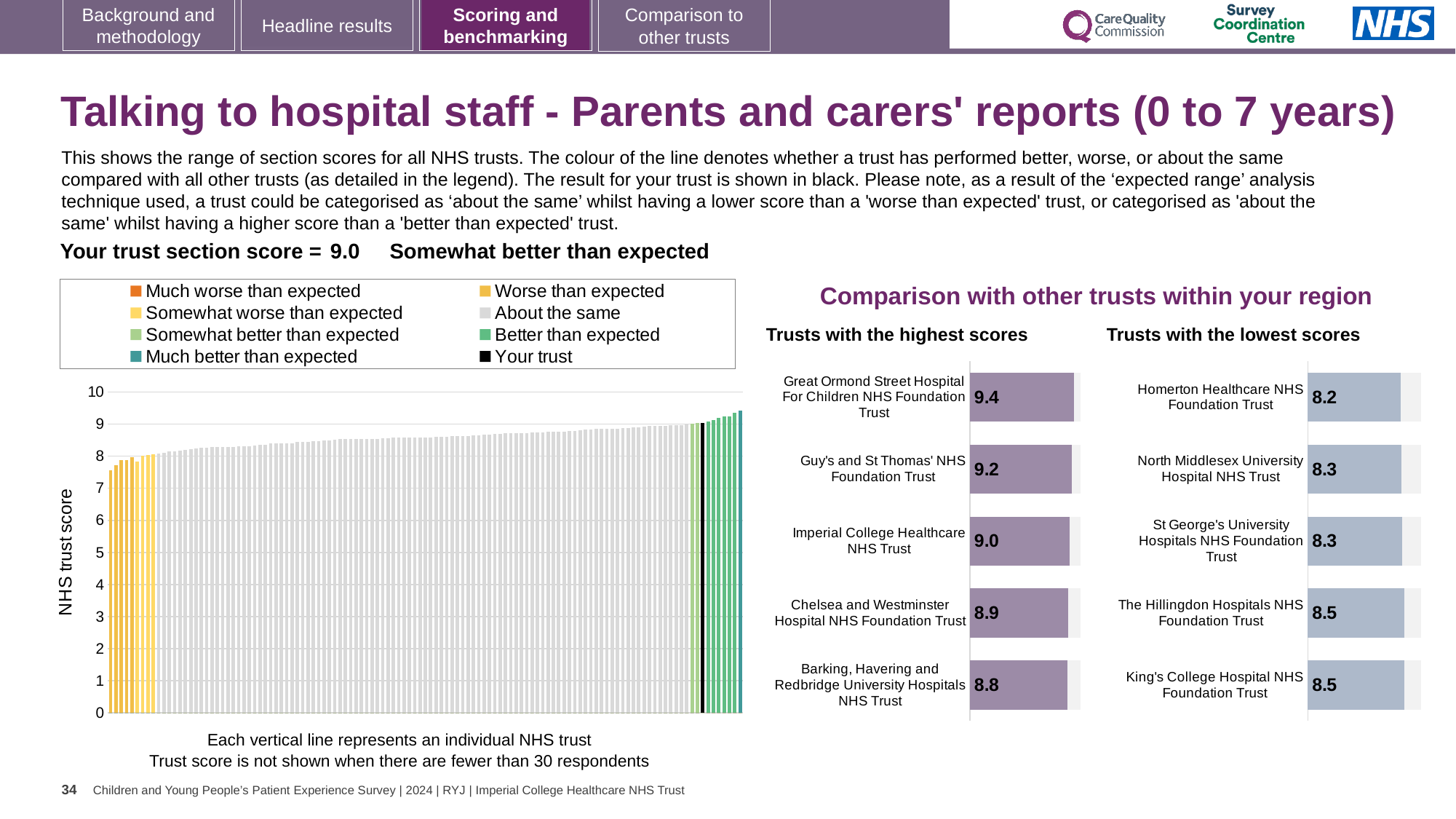
In the 'Trusts with the highest scores' chart, which trust has the lowest score? Barking, Havering and Redbridge University Hospitals NHS Trust What kind of chart is the main chart on the left showing all NHS trusts? Bar chart In the 'Trusts with the highest scores' chart, what is the score for Great Ormond Street Hospital For Children NHS Foundation Trust? 9.4 How many entries does the legend of the main chart on the left list? 8 In the 'Trusts with the highest scores' chart, what is the difference between the scores of Great Ormond Street Hospital For Children NHS Foundation Trust and Barking, Havering and Redbridge University Hospitals NHS Trust? 0.6 In the 'Trusts with the highest scores' chart, what is the score for Chelsea and Westminster Hospital NHS Foundation Trust? 8.9 How many trusts are shown in the 'Trusts with the lowest scores' chart? 5 In the 'Trusts with the lowest scores' chart, which has the larger score: North Middlesex University Hospital NHS Trust or The Hillingdon Hospitals NHS Foundation Trust? The Hillingdon Hospitals NHS Foundation Trust In the 'Trusts with the lowest scores' chart, which trust has the lowest score? Homerton Healthcare NHS Foundation Trust In the 'Trusts with the lowest scores' chart, what is the score for Homerton Healthcare NHS Foundation Trust? 8.2 In the main chart on the left, do the trust scores rise or fall from left to right? Rise In the 'Trusts with the lowest scores' chart, what is the difference between the scores of King's College Hospital NHS Foundation Trust and Homerton Healthcare NHS Foundation Trust? 0.3